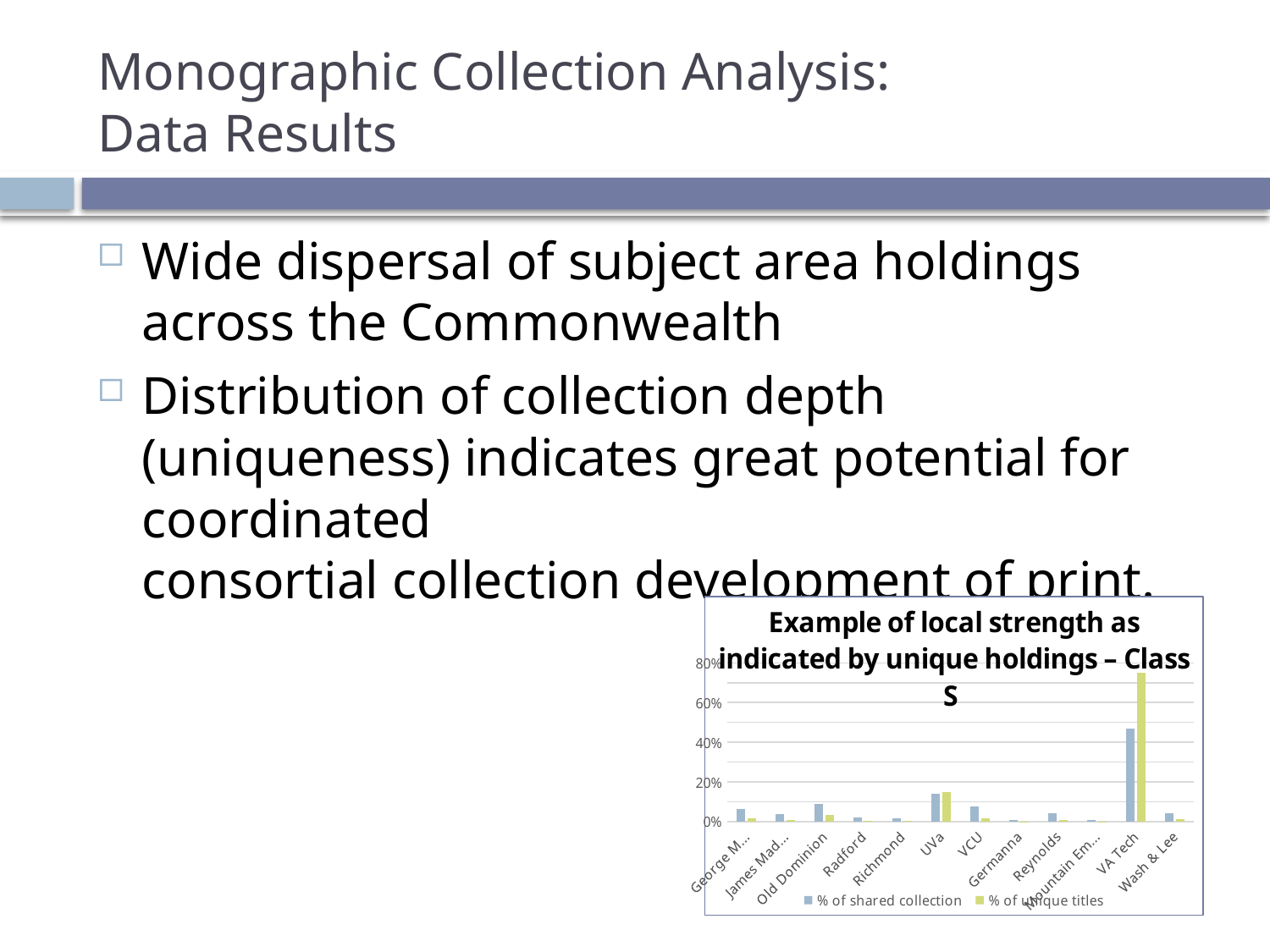
Is the % of unique titles value for VA Tech greater or less than 60%? greater What are the two series named in the chart's legend? % of shared collection and % of unique titles What is the title of the chart? Example of local strength as indicated by unique holdings – Class S Which has a larger % of shared collection, Old Dominion or Radford? Old Dominion What kind of chart is shown on the slide? Bar chart Which institution has the highest value for % of shared collection? VA Tech How many series does the chart's legend list? 2 How many institutions (categories) are shown along the x axis of the chart? 12 Is the % of shared collection value for VA Tech greater or less than 20%? greater Is the % of shared collection value for UVa greater or less than 20%? less Which has a larger % of unique titles, VA Tech or UVa? VA Tech Which institution has the highest value for % of unique titles? VA Tech